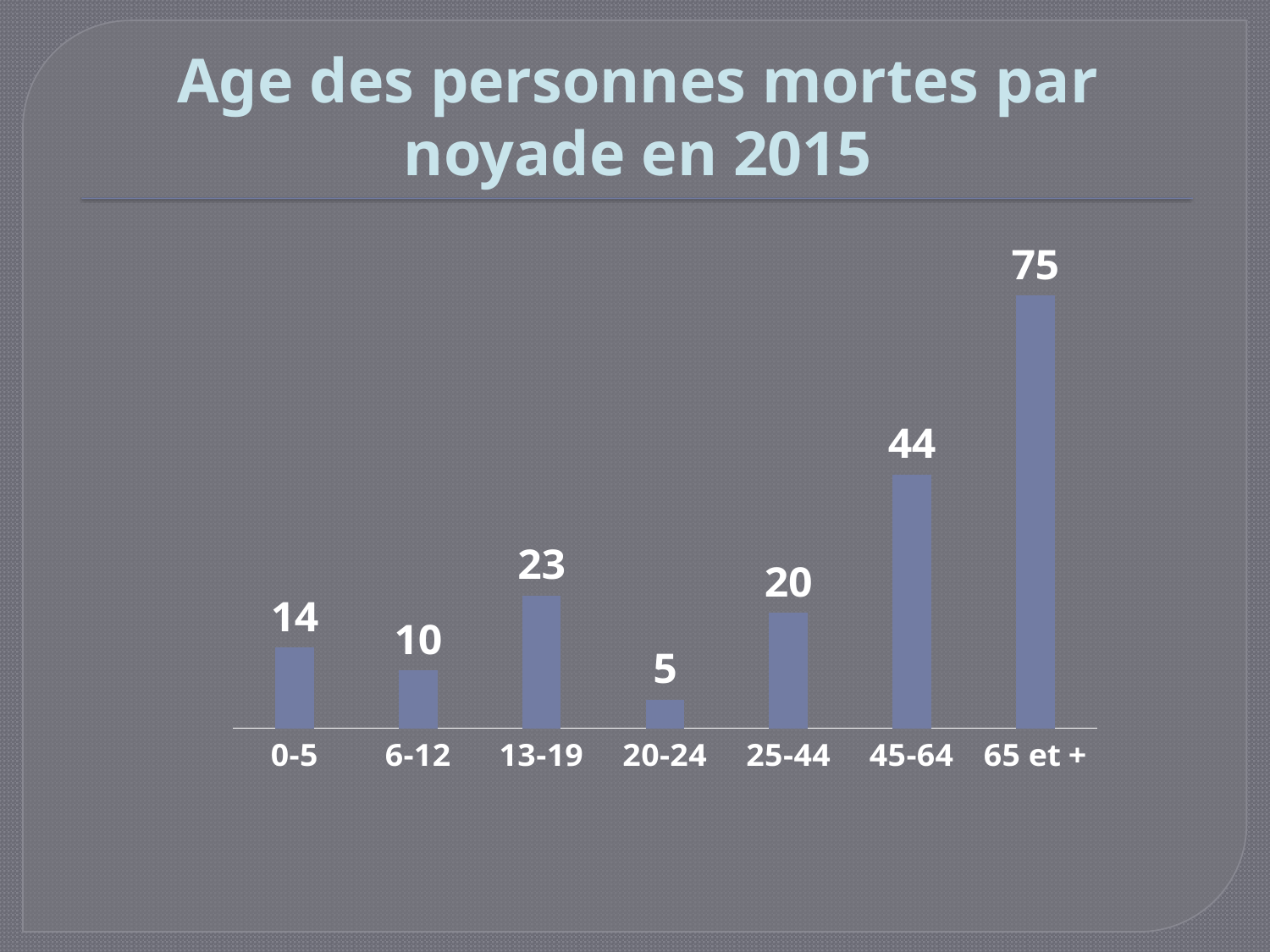
What is the value for the 0-5 age group? 14 What is the value for the 20-24 age group? 5 What is the title of the chart? Age des personnes mortes par noyade en 2015 What is the difference between the values for 65 et + and 45-64? 31 What kind of chart is shown on the slide? Bar chart How many age groups are shown on the chart? 7 What is the value for the 45-64 age group? 44 Which age group has the lowest value? 20-24 What is the difference between the values for 13-19 and 6-12? 13 Which age group has the highest value? 65 et + Which is larger, the value for 13-19 or the value for 25-44? 13-19 What is the value for the 65 et + age group? 75